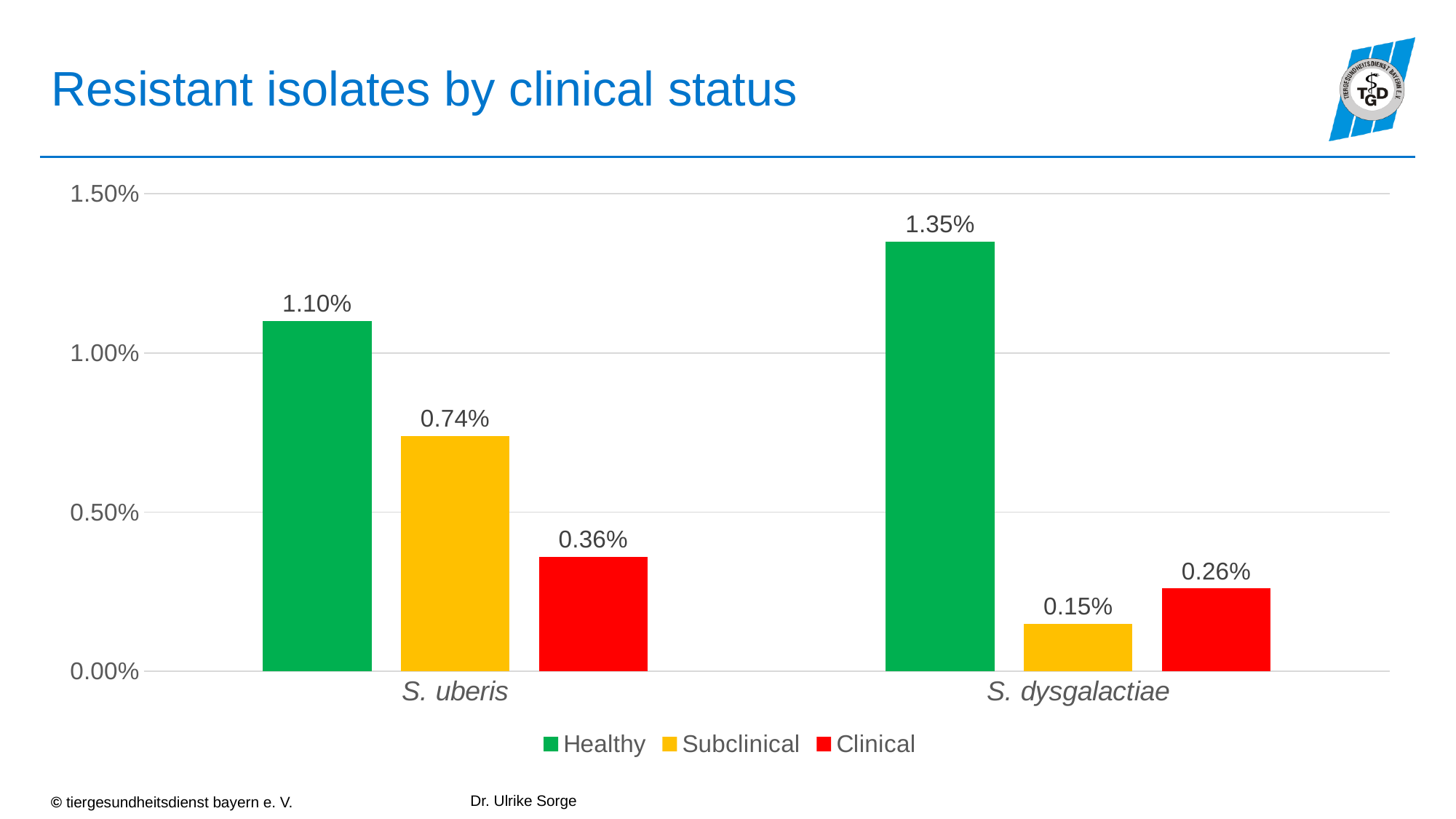
Which series has the lowest value for S. dysgalactiae? Subclinical How many series does the legend list? 3 What kind of chart is shown on the slide? bar chart What is the difference between the Healthy values for S. dysgalactiae and S. uberis? 0.25% What is the Clinical value for S. uberis? 0.36% What is the Healthy value for S. uberis? 1.10% Which category has the highest Healthy value? S. dysgalactiae What is the difference between the Subclinical and Clinical values for S. uberis? 0.38% What is the Subclinical value for S. dysgalactiae? 0.15% Which is larger, the Clinical value for S. uberis or the Clinical value for S. dysgalactiae? S. uberis Is the Healthy value for S. dysgalactiae greater or less than 1.00%? greater How many categories are shown on the x axis? 2